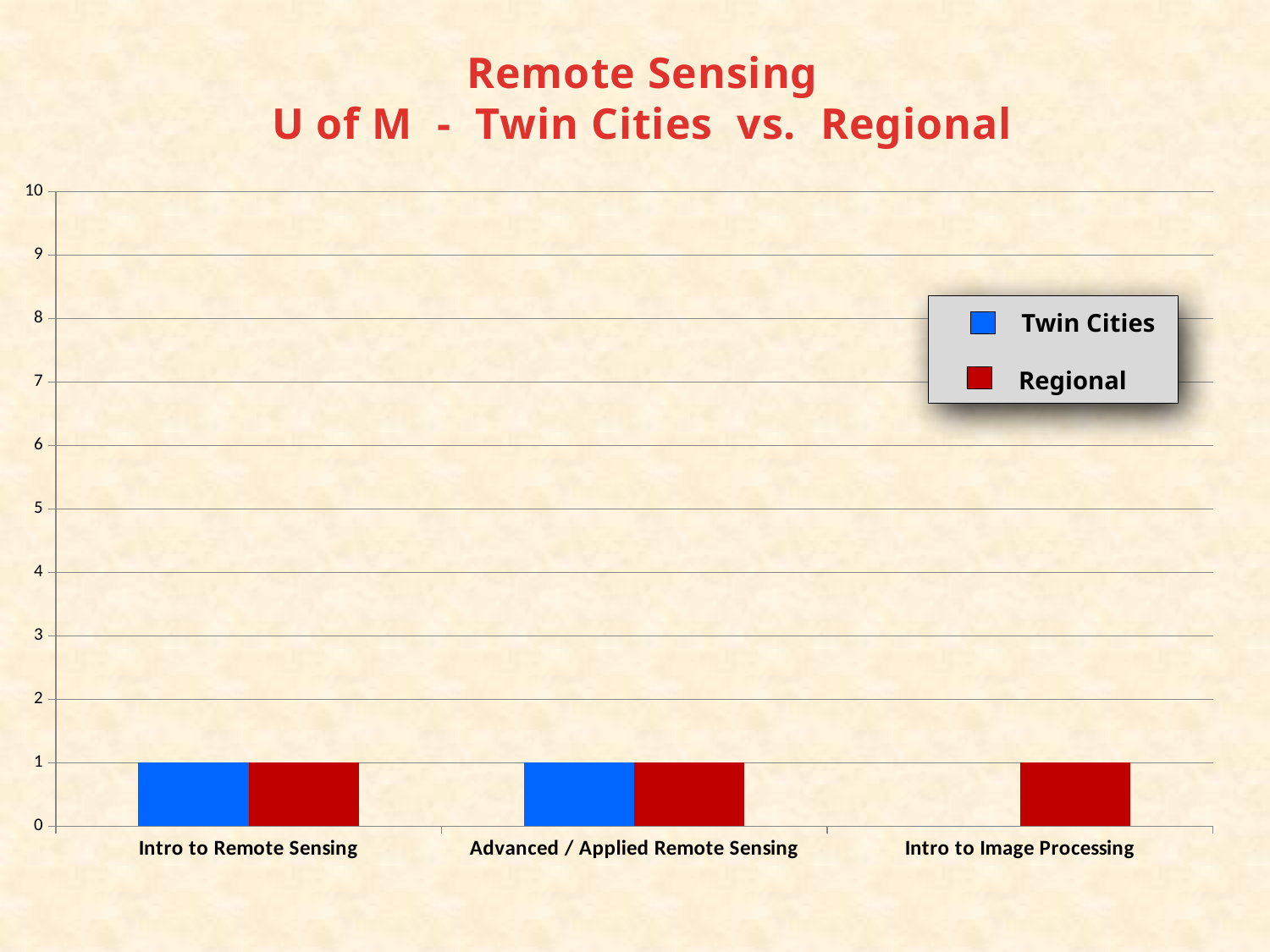
What is the Regional value for Intro to Image Processing? 1 What is the Twin Cities value for Intro to Remote Sensing? 1 Which series is shown in red in the legend? Regional How many categories are shown on the x axis? 3 What kind of chart is shown on the slide? bar chart Which is larger for Intro to Image Processing, the Twin Cities value or the Regional value? Regional Is the Regional value for Intro to Remote Sensing greater or less than 5? less What is the Regional value for Advanced / Applied Remote Sensing? 1 How many series does the legend list? 2 What is the difference between the Regional and Twin Cities values for Intro to Image Processing? 1 Which category has the lowest Twin Cities value? Intro to Image Processing What is the Twin Cities value for Intro to Image Processing? 0